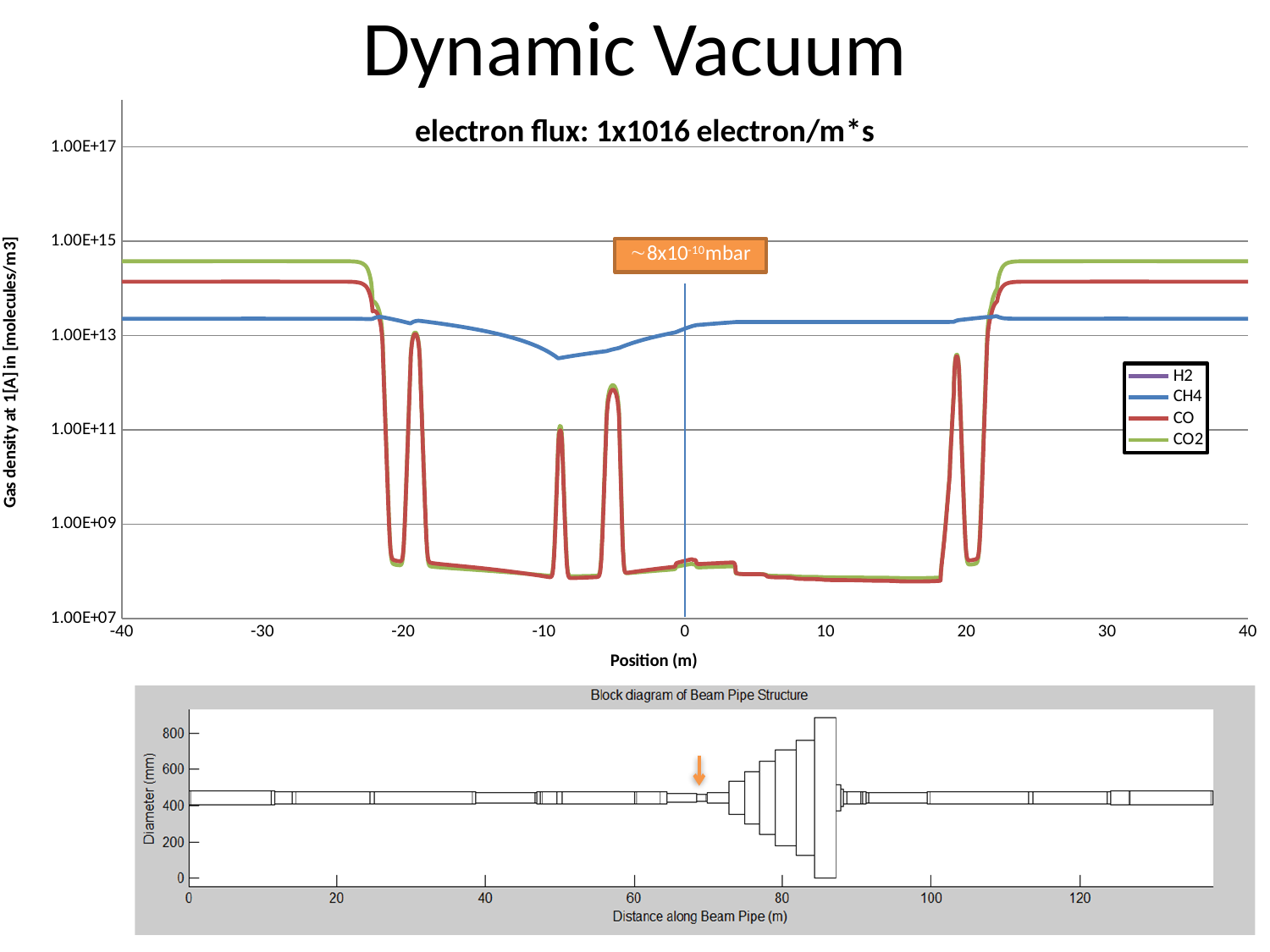
In the upper chart, is the CH4 gas density at position -10 m greater or less than 1.00E+13? less What is the x-axis label of the lower chart titled 'Block diagram of Beam Pipe Structure'? Distance along Beam Pipe (m) In the upper chart, is the CH4 gas density at position -40 m greater or less than 1.00E+13? greater In the upper chart, does the CH4 gas density rise or fall as position goes from -20 m to -10 m? fall In the upper chart, which is larger at position 10 m: the CH4 density or the CO density? CH4 In the upper chart, which series has the highest gas density at position -40 m? CO2 How many series does the legend of the upper chart list? 4 What is the title shown above the upper chart? electron flux: 1x1016 electron/m*s What kind of chart is the upper chart on the slide? line chart In the upper chart, is the CO2 gas density at position 40 m greater or less than 1.00E+15? less In the upper chart, which series has the highest gas density at position 0 m? CH4